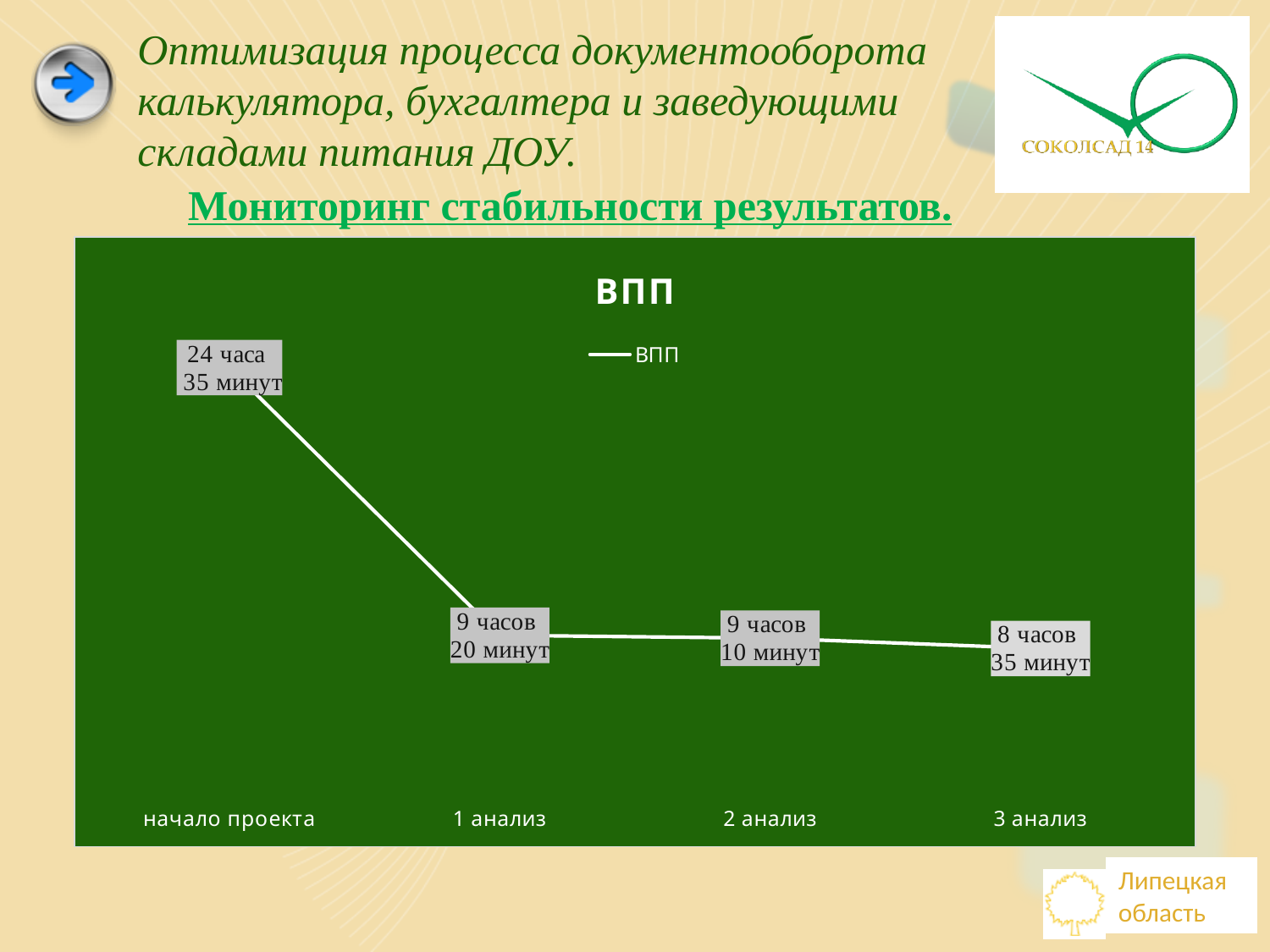
What type of chart is shown on the slide? line chart Which category has the lowest value on the ВПП chart? 3 анализ What is the value for начало проекта on the ВПП chart? 24 часа 35 минут What is the value for 1 анализ on the ВПП chart? 9 часов 20 минут By how much does the value for 2 анализ exceed the value for 3 анализ on the ВПП chart? 35 минут What is the value for 2 анализ on the ВПП chart? 9 часов 10 минут How many series does the legend of the ВПП chart list? 1 By how much does the value for 1 анализ exceed the value for 2 анализ on the ВПП chart? 10 минут What is the value for 3 анализ on the ВПП chart? 8 часов 35 минут How many data points are plotted on the ВПП chart? 4 Which is larger on the ВПП chart: the value for 1 анализ or the value for 3 анализ? 1 анализ Which category has the highest value on the ВПП chart? начало проекта